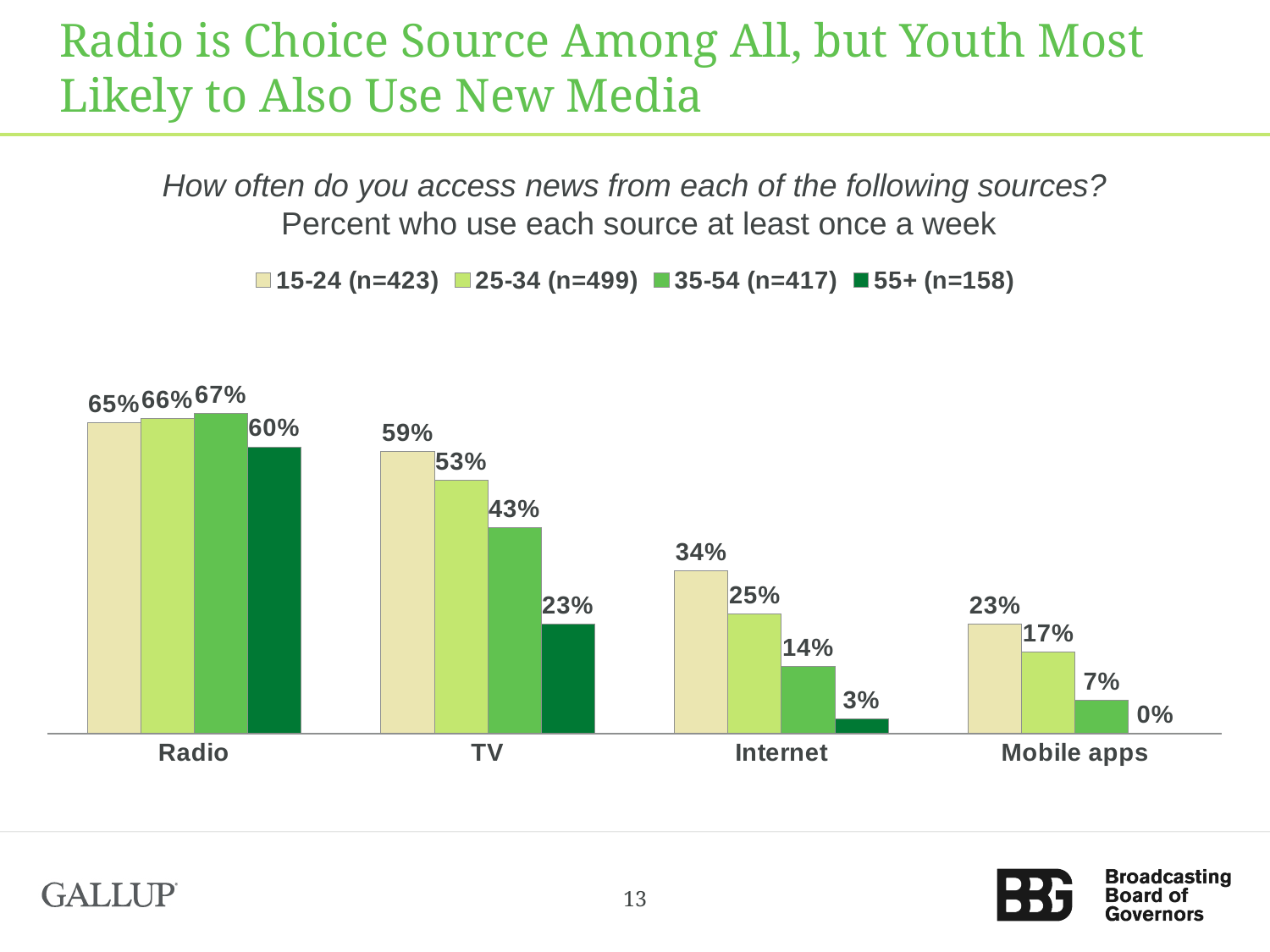
What is the sample size (n) for the 25-34 age group shown in the legend? 499 What percentage of the 15-24 age group uses TV for news at least once a week? 59% For Mobile apps, do the values rise or fall as the age group gets older? Fall How many age groups does the legend list? 4 Which news source has the lowest value for the 15-24 group? Mobile apps Which is larger for TV: the 25-34 value or the 35-54 value? 25-34 How many news sources are shown on the x axis? 4 What is the value for the 55+ group for Internet? 3% What is the value for the 35-54 group for Mobile apps? 7% What kind of chart is shown on the slide? Bar chart What is the difference between the 15-24 and 55+ values for Internet? 31% Which news source has the highest value for the 55+ group? Radio